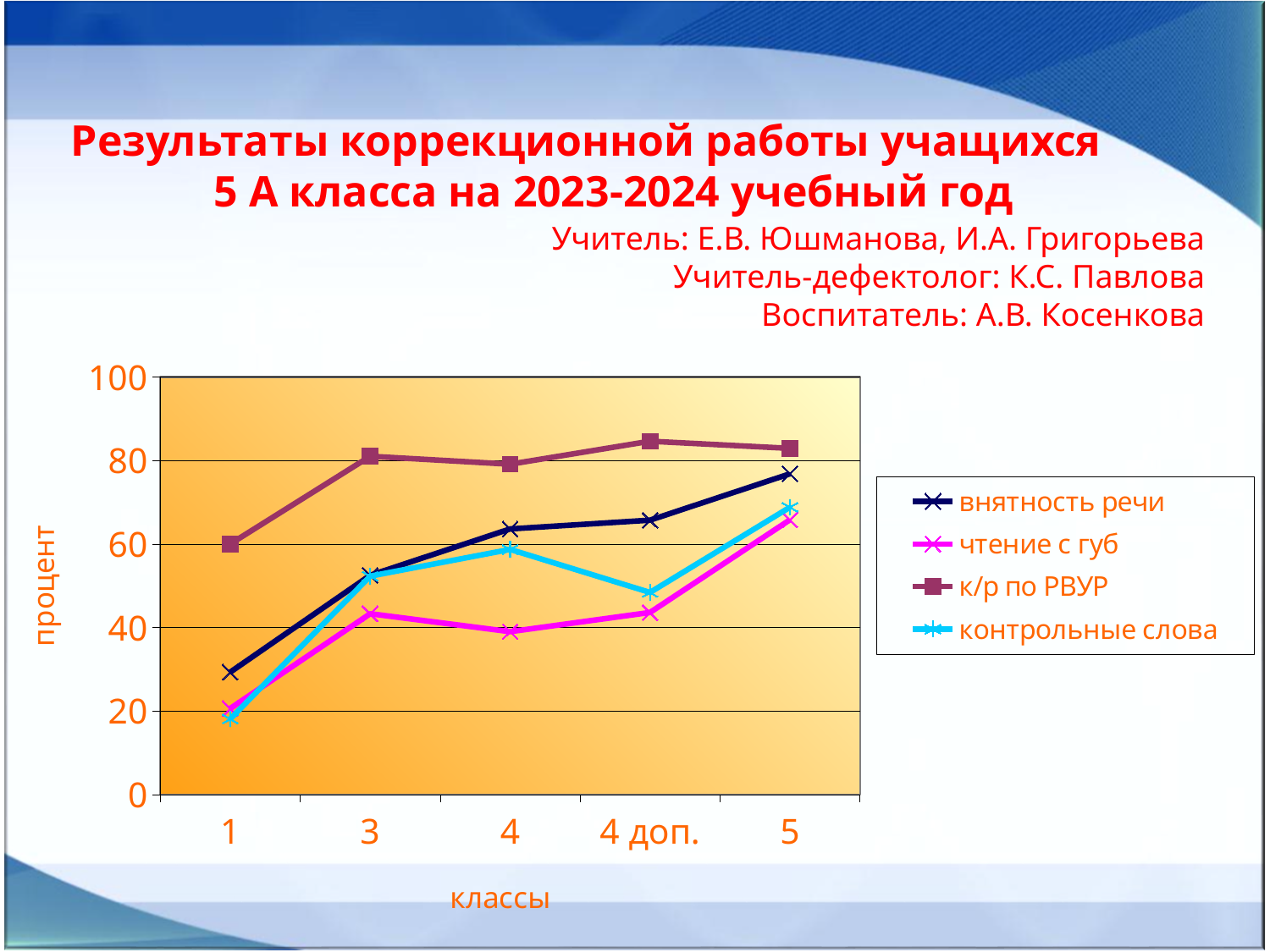
At category 4 доп., which is larger: контрольные слова or чтение с губ? контрольные слова What kind of chart is shown on the slide? line chart How many categories are shown along the x axis? 5 Which series has the highest value at category 1? к/р по РВУР Is the value of внятность речи at category 5 greater or less than 60? greater How many series does the legend list? 4 What is the value of к/р по РВУР at category 1? 60 What is the label of the x axis? классы Is the value of чтение с губ at category 1 greater or less than 40? less Is the value of к/р по РВУР at category 4 доп. greater or less than 80? greater What is the label of the y axis? процент Does the внятность речи series rise or fall from category 1 to category 5? rise